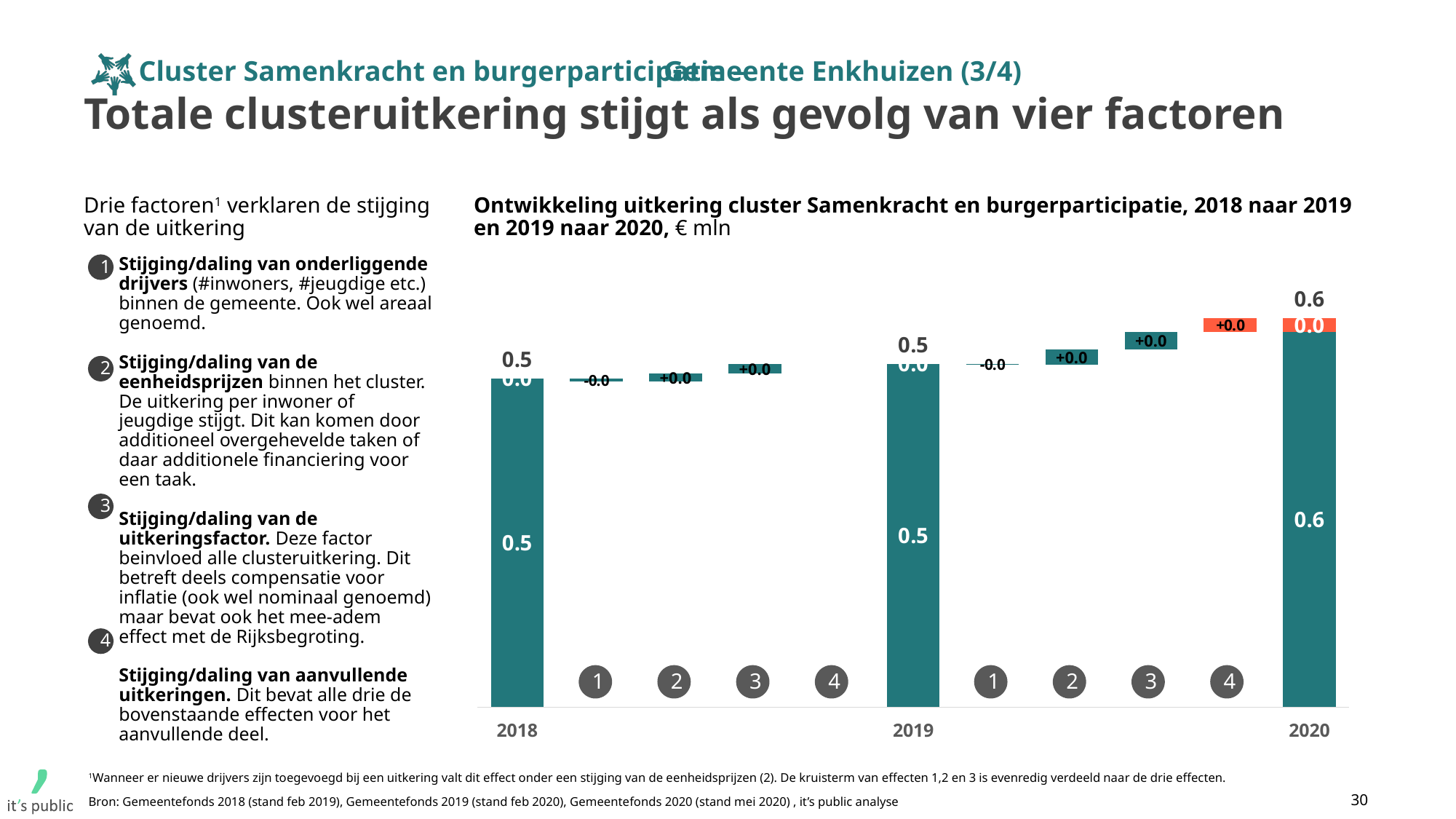
What is the data label on the factor 4 bar between 2019 and 2020? +0.0 What is the difference between the 2020 total and the 2018 total? 0.1 What is the total value shown above the 2019 bar? 0.5 What is the total value shown above the 2020 bar? 0.6 Which year has the highest total bar in the chart? 2020 How many year totals (2018, 2019, 2020) are shown as full bars in the chart? 3 What is the value of the large teal segment of the 2020 bar? 0.6 What is the data label on the factor 1 bar between 2018 and 2019? -0.0 Do the year totals rise or fall from 2018 to 2020? rise Is the 2020 total larger or smaller than the 2019 total? larger What is the total value shown above the 2018 bar? 0.5 What unit is stated in the chart title? € mln